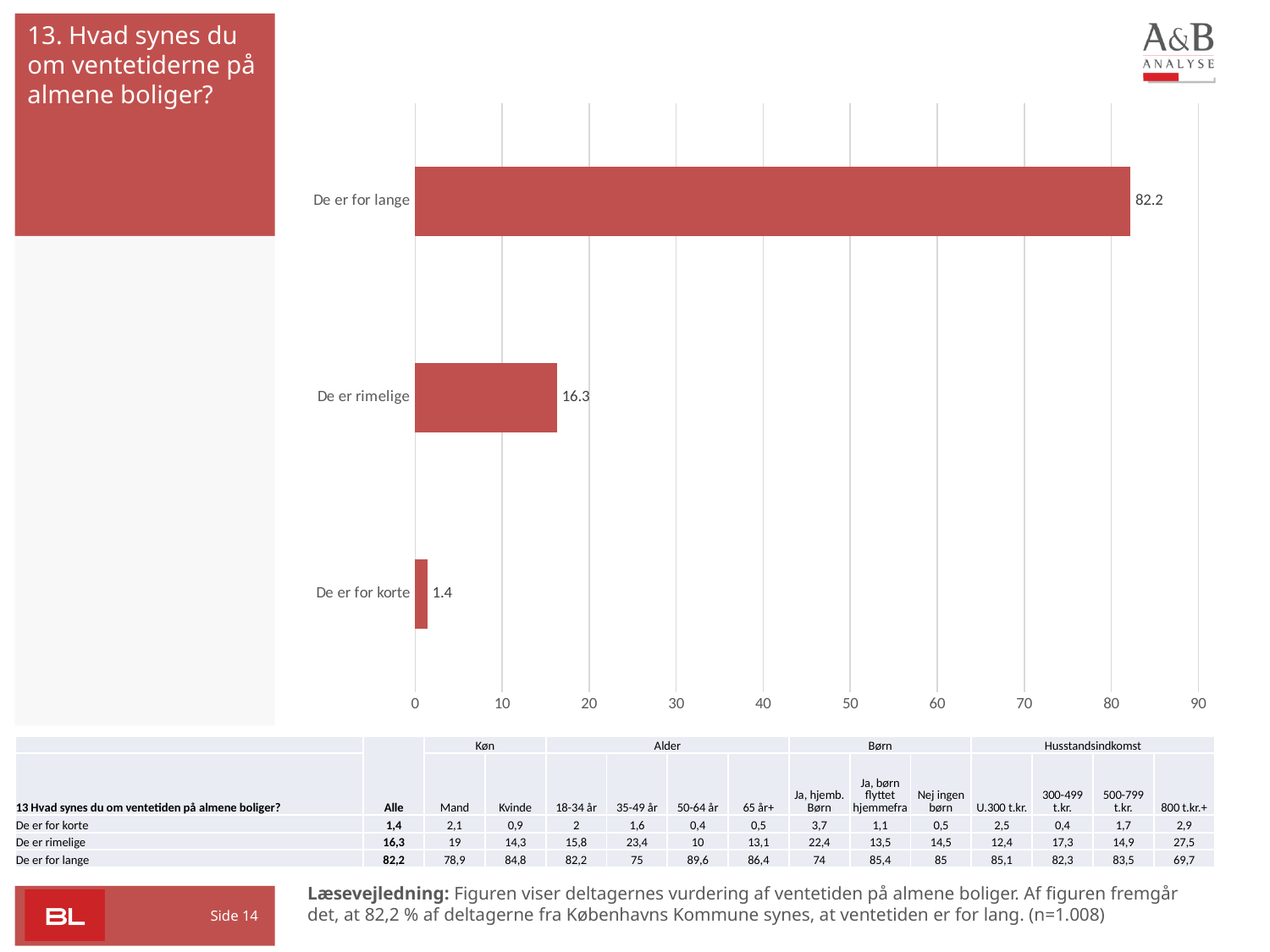
Which category has the highest value? De er for lange Is the value for "De er for lange" greater or less than 80? greater What is the value for "De er for lange"? 82.2 How many categories are shown in the chart? 3 Which category has the lowest value? De er for korte What is the difference between the values for "De er rimelige" and "De er for korte"? 14.9 What kind of chart is shown on the slide? Bar chart Which is larger, the value for "De er rimelige" or the value for "De er for korte"? De er rimelige What is the value for "De er for korte"? 1.4 What is the value for "De er rimelige"? 16.3 What is the highest value shown on the horizontal axis of the chart? 90 What is the difference between the values for "De er for lange" and "De er rimelige"? 65.9